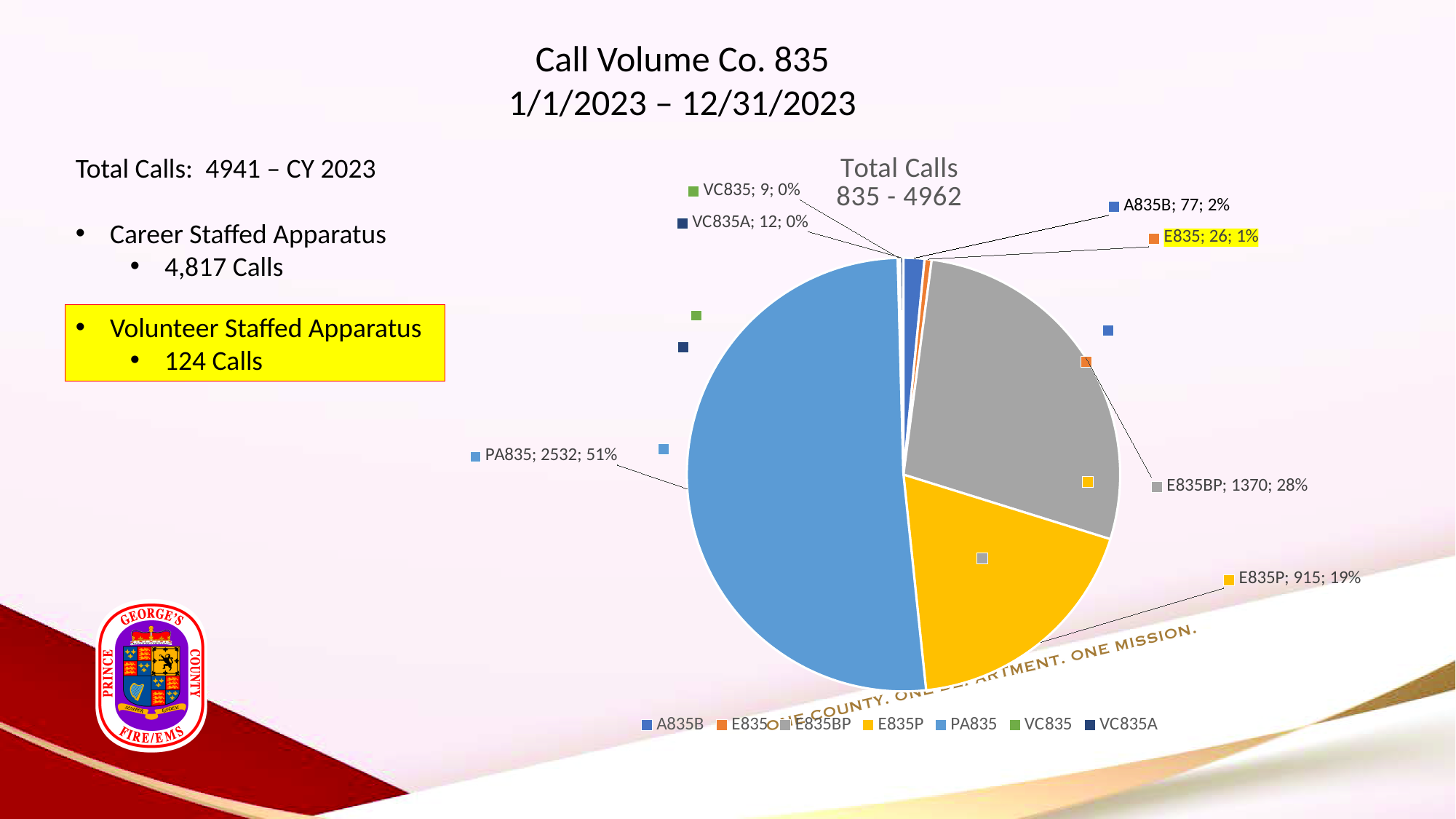
How many calls are shown for PA835? 2532 Which category has the largest slice of the pie? PA835 Which has more calls, A835B or E835? A835B How many calls are shown for E835BP? 1370 Which category has the smallest slice of the pie? VC835 What share of the pie does PA835 represent? 51% How many calls are shown for VC835A? 12 How many entries does the legend list? 7 What type of chart is shown on the slide? pie chart What share of the pie does E835P represent? 19% What is the chart's title? Total Calls 835 - 4962 What is the difference in calls between E835BP and E835P? 455